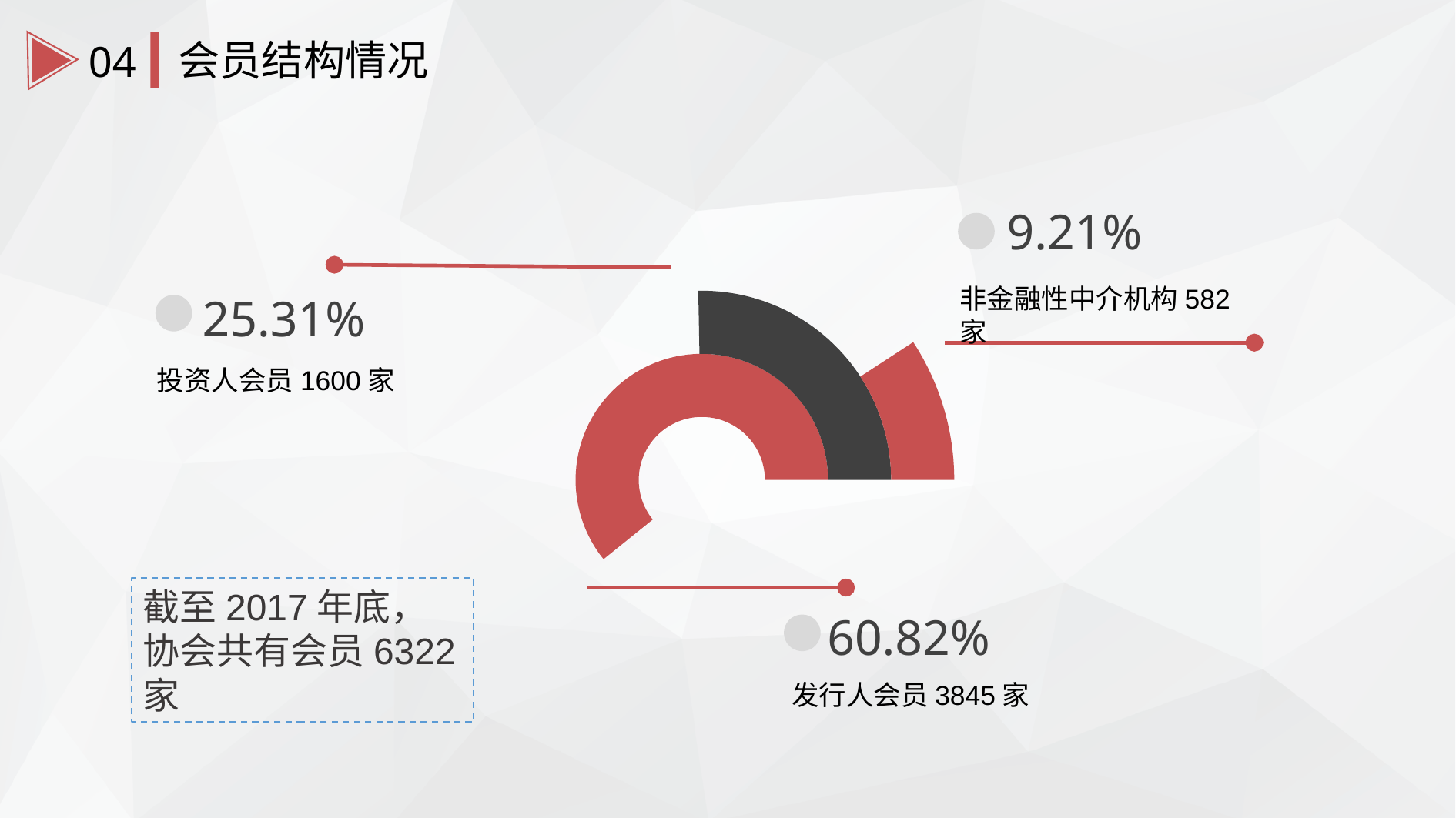
How many member categories are shown in the chart? 3 How many more 发行人会员 are there than 投资人会员? 2245 家 How many 非金融性中介机构 members are there? 582 家 What is the total number of members stated on the slide as of the end of 2017? 6322 家 How many 发行人会员 are there according to the slide? 3845 家 What is the title of the slide? 会员结构情况 Which has more members, 投资人会员 or 非金融性中介机构? 投资人会员 Which member category has the largest share? 发行人会员 What percentage is shown for 非金融性中介机构? 9.21% What percentage share is shown for 投资人会员? 25.31% What is the difference in percentage points between 发行人会员 (60.82%) and 投资人会员 (25.31%)? 35.51 Which member category has the smallest share? 非金融性中介机构